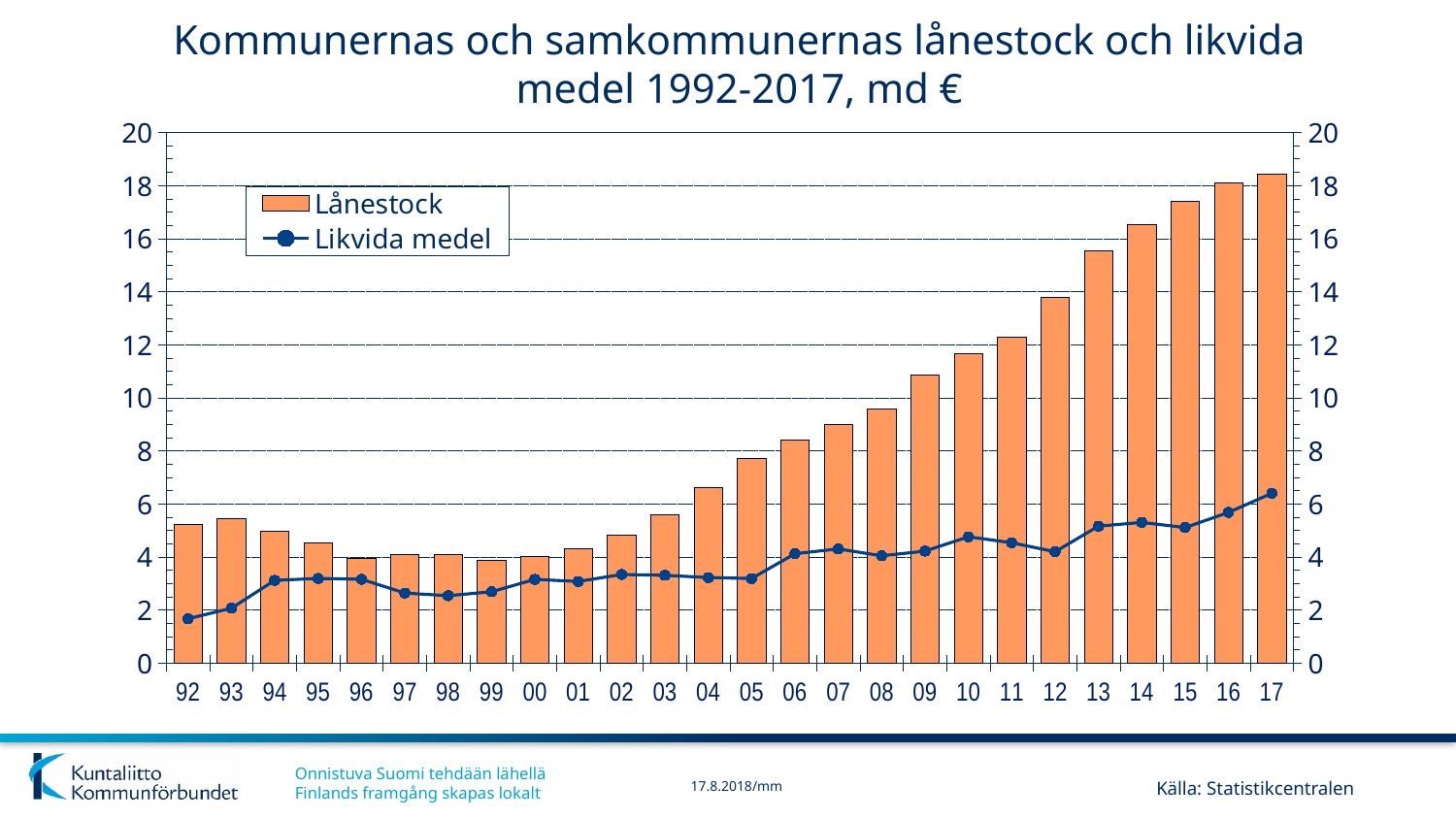
In which year is Lånestock highest? 17 What kind of chart is shown on the slide? A combined bar and line chart Is the Lånestock value for 17 greater or less than 16? greater How many series does the legend list? 2 Which year has the larger Lånestock value, 05 or 10? 10 Which two series are listed in the legend? Lånestock and Likvida medel Is the Lånestock value for 13 greater or less than 14? greater Is the Likvida medel value for 17 greater or less than 6? greater Does Lånestock rise or fall from 05 to 17? rise How many years are shown along the x axis? 26 In which year is Likvida medel lowest? 92